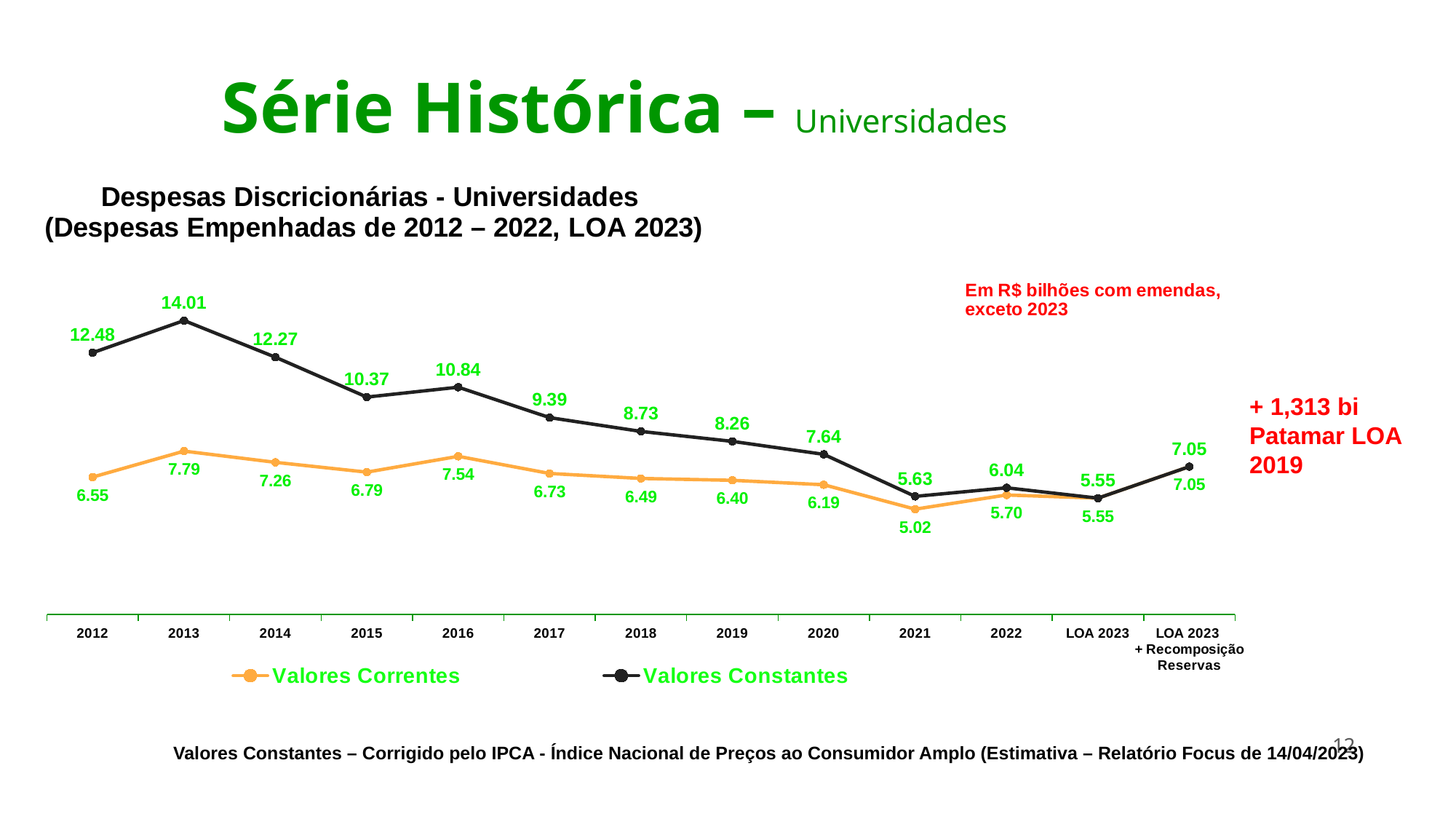
How many points are plotted along the x axis for each series? 13 What colour is the Valores Correntes line? Orange In which year does the Valores Constantes series reach its highest value? 2013 What is the Valores Correntes value for LOA 2023 + Recomposição Reservas? 7.05 What is the Valores Constantes value for 2013? 14.01 What is the difference between the Valores Constantes values for 2012 and 2022? 6.44 What is the Valores Correntes value for 2020? 6.19 Does the Valores Constantes series generally rise or fall from 2013 to 2021? Fall In which year does the Valores Correntes series reach its lowest value? 2021 Which is larger, the Valores Constantes value for 2016 or for 2015? 2016 How many series does the legend list? 2 What type of chart is shown on the slide? Line chart